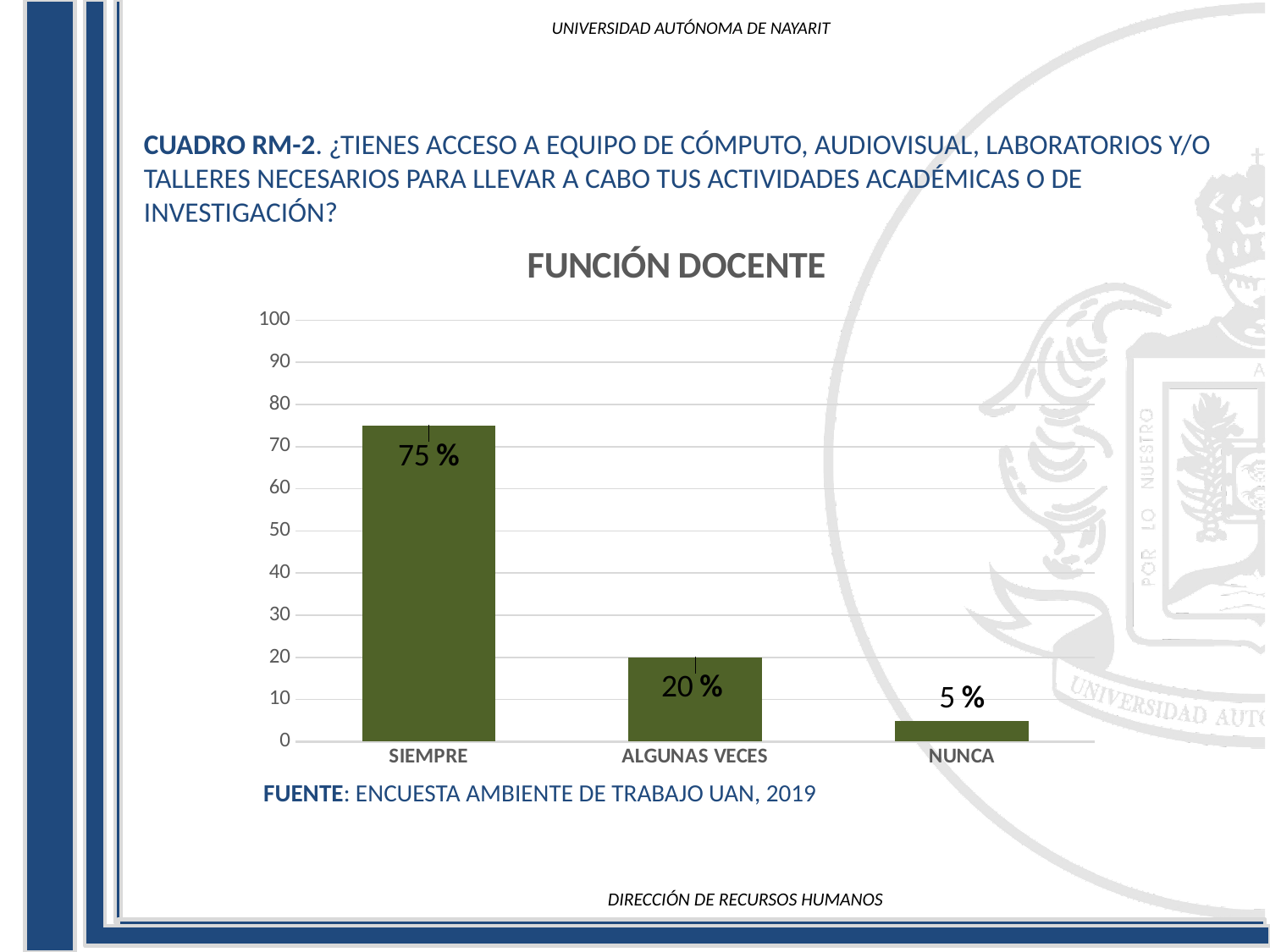
What kind of chart is shown on the slide? bar chart What is the title of the chart? FUNCIÓN DOCENTE What is the value for NUNCA? 5 % What is the difference between the values for ALGUNAS VECES and NUNCA? 15 % Which category has the lowest value? NUNCA Which category has the highest value? SIEMPRE How many categories are shown on the x axis? 3 Which is larger, the value for ALGUNAS VECES or the value for NUNCA? ALGUNAS VECES What is the value for ALGUNAS VECES? 20 % Is the value for SIEMPRE greater or less than 70? greater What is the value for SIEMPRE? 75 % What is the difference between the values for SIEMPRE and ALGUNAS VECES? 55 %